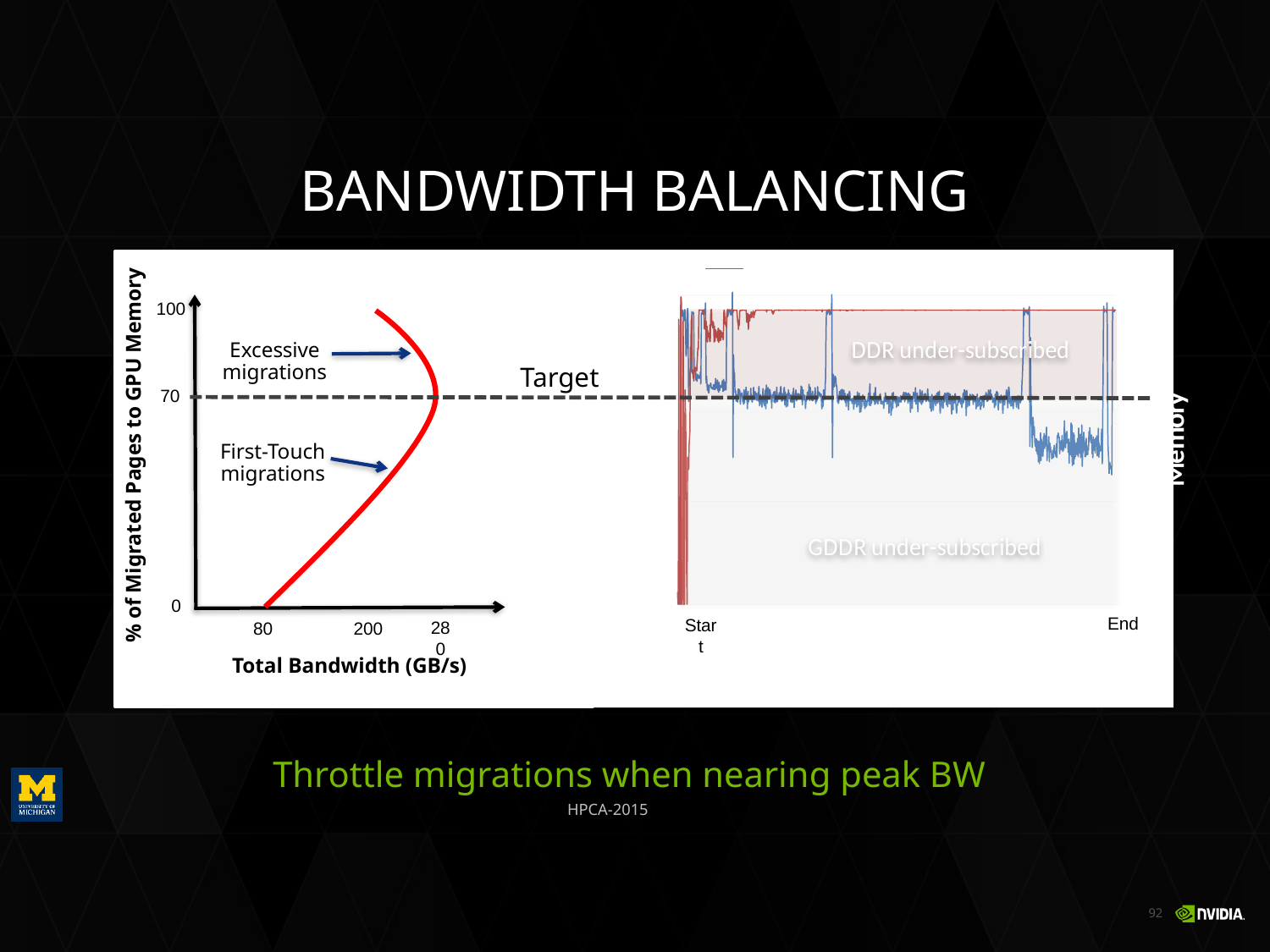
On the left chart, what is the highest value labelled on the y-axis? 100 What kind of chart is the left chart? line chart On the left chart, is the bandwidth at which the red curve touches the Target line greater or less than 200 GB/s? greater What kind of chart is the right chart? line chart On the left chart, how many tick values are labelled on the Total Bandwidth axis? 3 What is the x-axis label of the left chart? Total Bandwidth (GB/s) On the left chart, what is the lowest value labelled on the y-axis? 0 On the right chart, which region label appears above the Target line? DDR under-subscribed On the left chart, at what percentage of migrated pages is the dashed Target line drawn? 70 On the left chart, what is the largest bandwidth value labelled on the x-axis? 280 On the left chart, at what bandwidth value does the red curve meet the 0% level? 80 On the right chart, how many coloured lines are plotted? 2